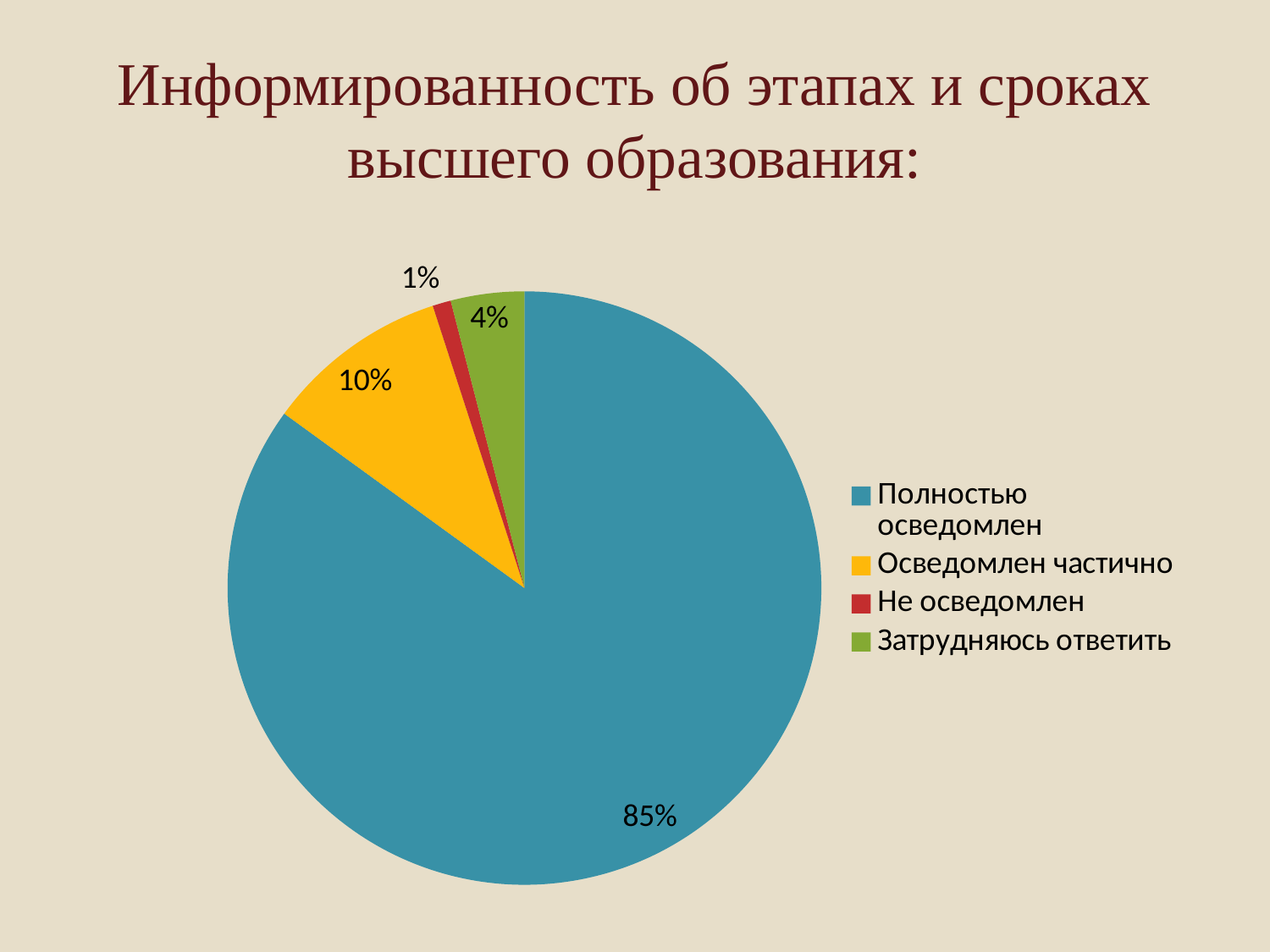
What share of the pie is labelled "Полностью осведомлен"? 85% What is the difference between the shares for "Полностью осведомлен" and "Осведомлен частично"? 75% Which category has the largest slice of the pie? Полностью осведомлен How many slices does the pie chart have? 4 What kind of chart is shown on the slide? pie chart How many entries does the legend list? 4 What share of the pie is labelled "Затрудняюсь ответить"? 4% Which is larger: the share for "Затрудняюсь ответить" or the share for "Не осведомлен"? Затрудняюсь ответить Which category has the smallest slice of the pie? Не осведомлен What share of the pie is labelled "Не осведомлен"? 1% What share of the pie is labelled "Осведомлен частично"? 10% What colour is the slice for "Осведомлен частично"? yellow